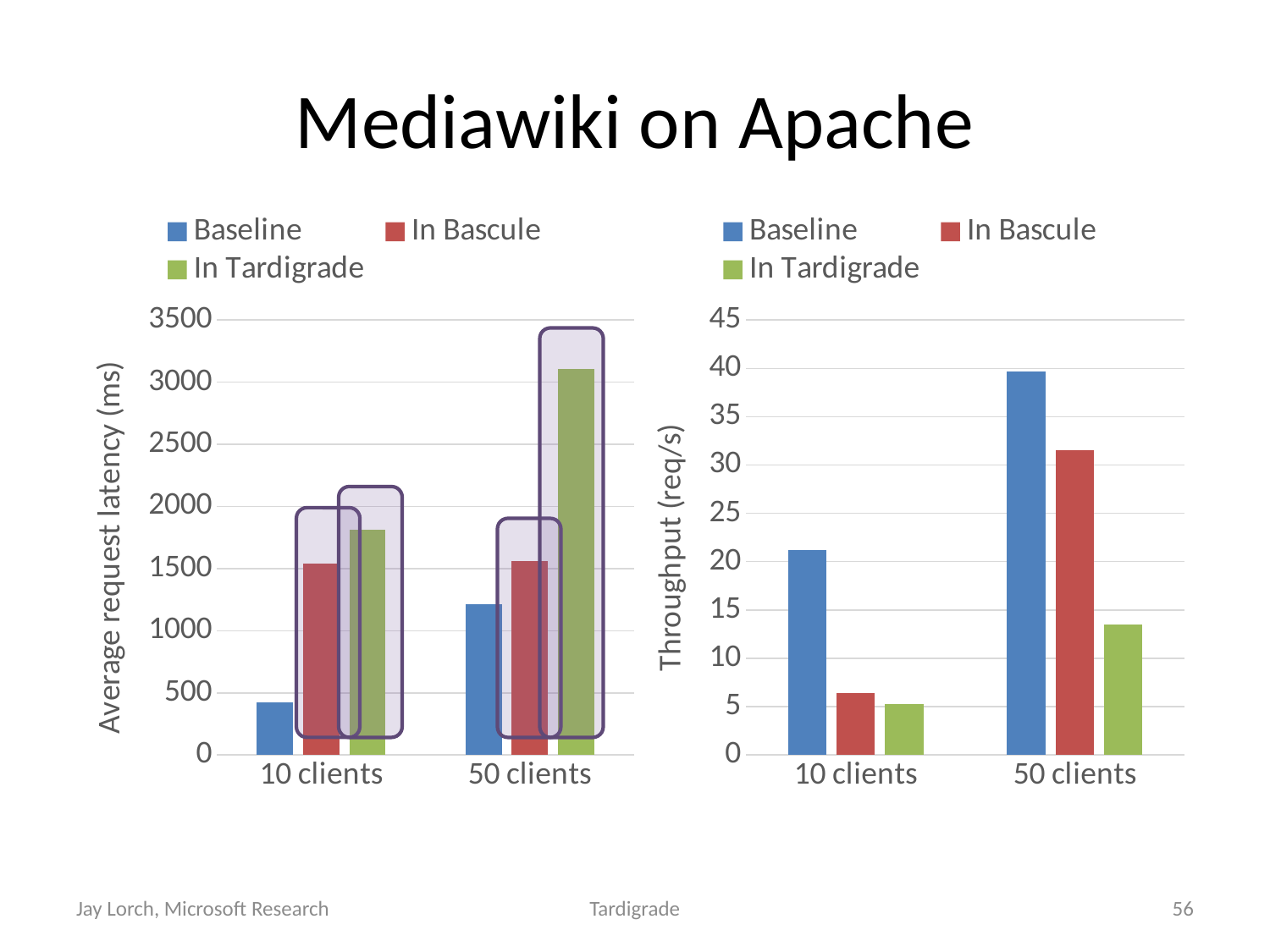
What kind of chart is the right chart (Throughput)? bar chart On the right chart (Throughput), is the Baseline value for 10 clients greater or less than 20? greater On the left chart (Average request latency), is the Baseline value for 10 clients greater or less than 500? less On the right chart (Throughput), is the In Tardigrade value for 50 clients greater or less than 15? less On the left chart (Average request latency), which series has the highest latency for 50 clients? In Tardigrade On the right chart (Throughput), which series has the lowest throughput for 10 clients? In Tardigrade On the left chart (Average request latency), does the Baseline latency rise or fall from 10 clients to 50 clients? rise On the left chart (Average request latency), which series has the lowest latency for 10 clients? Baseline On the right chart (Throughput), which series has the highest throughput for 50 clients? Baseline How many series does the legend of the left chart list? 3 On the right chart (Throughput), which is larger for 50 clients: Baseline or In Bascule? Baseline